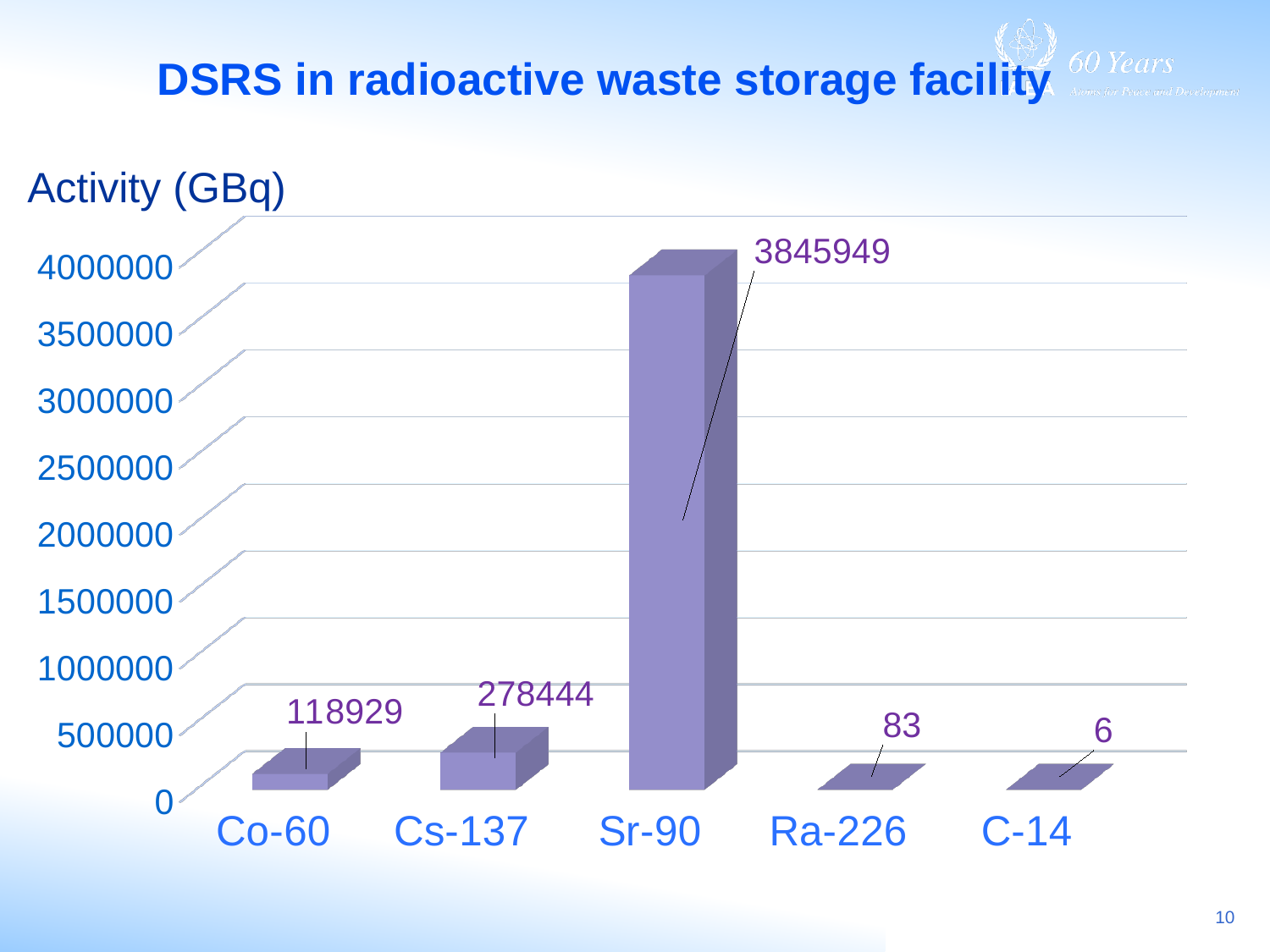
What kind of chart is shown on the slide? Bar chart What is the difference between the activity of Cs-137 and Co-60? 159515 What is the activity value for Sr-90? 3845949 Which has a larger activity, Co-60 or Cs-137? Cs-137 What is the activity value for Ra-226? 83 Which category has the highest activity? Sr-90 What unit is given for the activity axis? GBq What is the activity value for Co-60? 118929 What is the activity value for C-14? 6 Which category has the lowest activity? C-14 What is the activity value for Cs-137? 278444 How many categories are shown on the x axis? 5